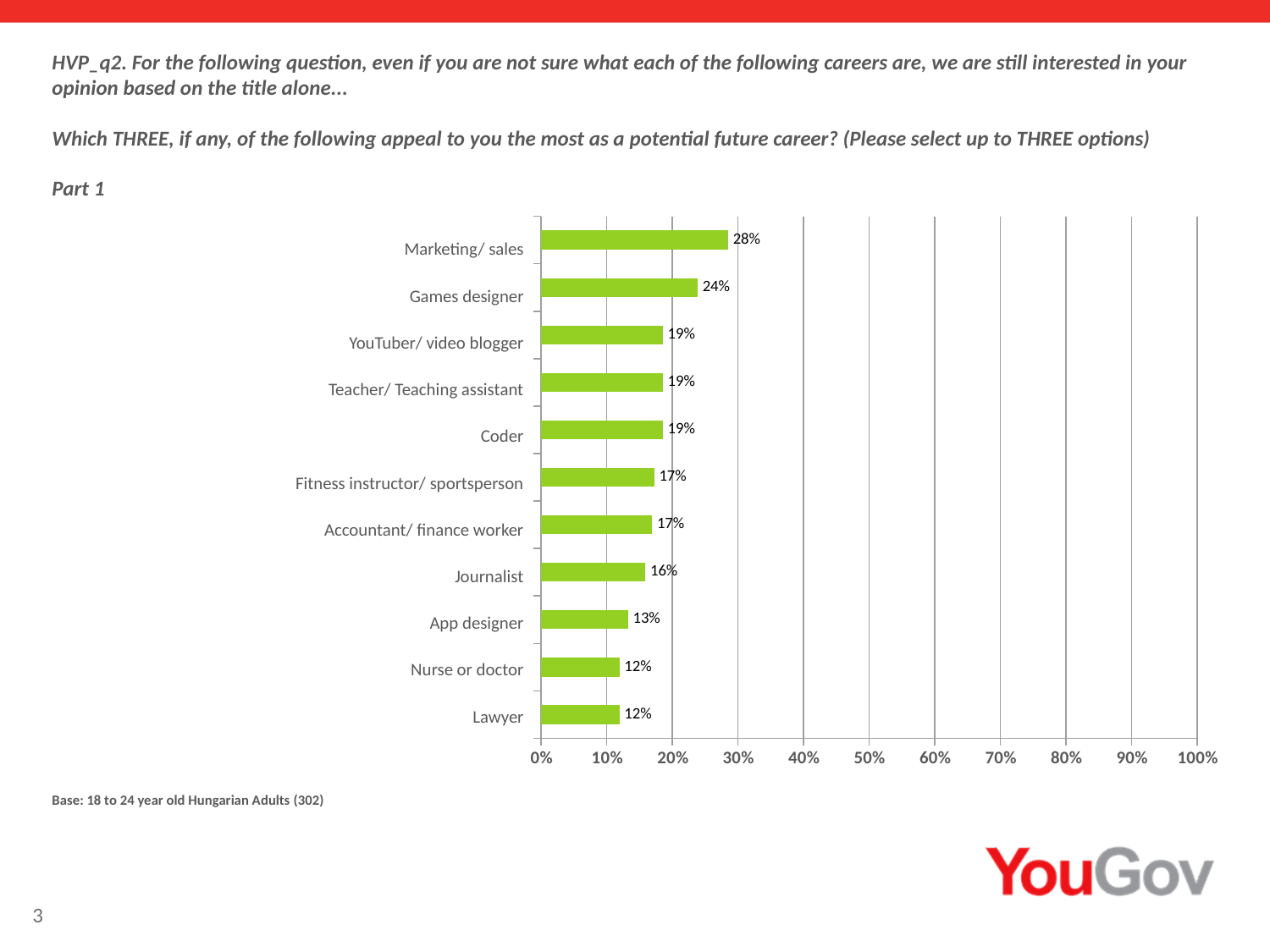
What percentage of respondents selected Marketing/ sales as an appealing future career? 28% What is the value shown for Games designer? 24% What is the difference in percentage points between Coder and Lawyer? 7 What is the difference in percentage points between Marketing/ sales and Games designer? 4 Which has a higher value, Games designer or Journalist? Games designer What is the value for App designer? 13% What percentage is shown for Journalist? 16% What is the maximum value shown on the percentage axis? 100% Is the value for Marketing/ sales greater or less than 20%? greater How many careers are listed on the chart? 11 What type of chart is shown on the slide? Bar chart Which career has the highest percentage on the chart? Marketing/ sales